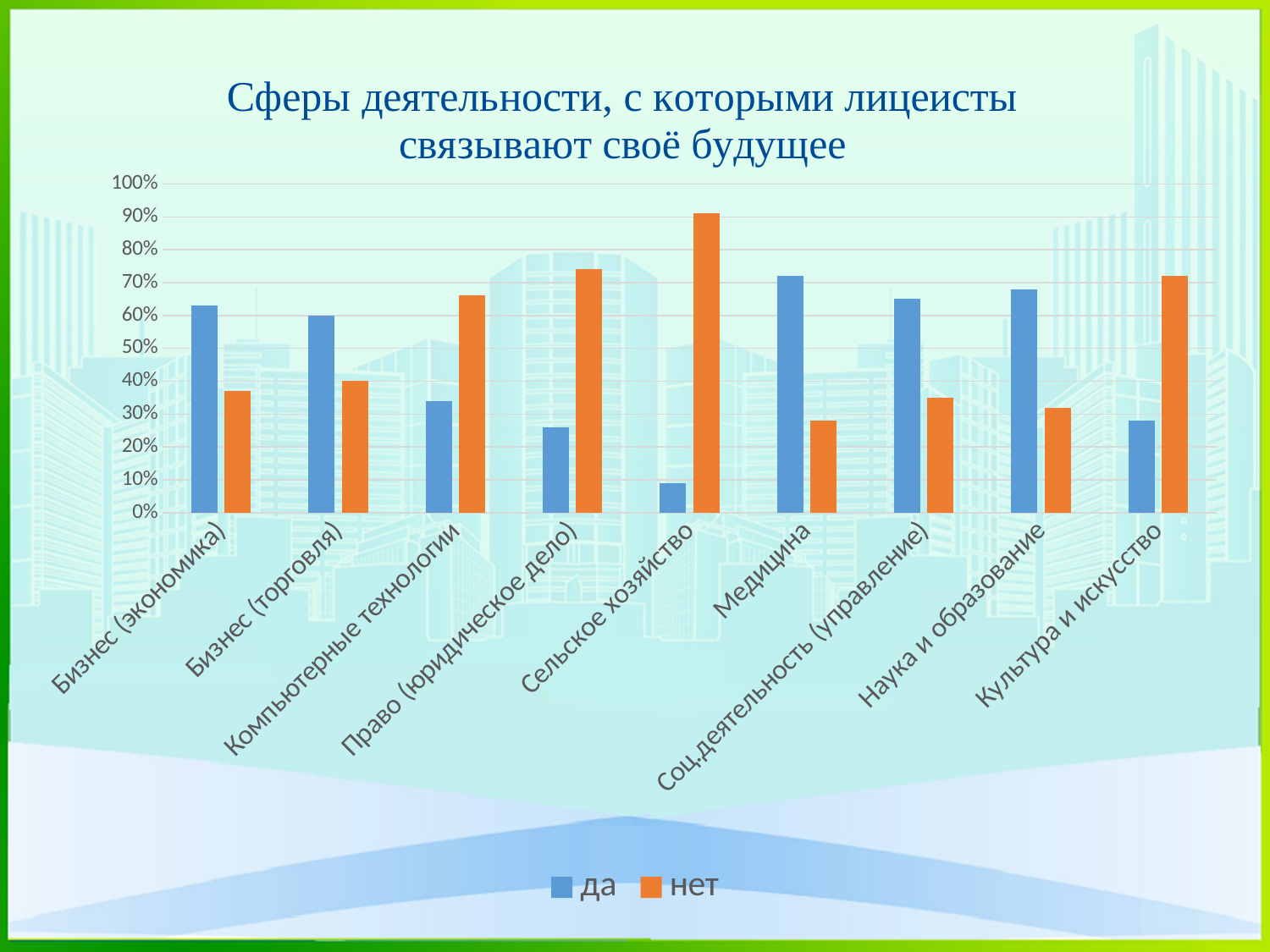
What are the two series named in the legend? да and нет Is the 'да' value for Медицина greater or less than 60%? greater Is the 'нет' value for Сельское хозяйство greater or less than 80%? greater For Культура и искусство, which series has the larger value, 'да' or 'нет'? нет Is the 'нет' value for Право (юридическое дело) greater or less than 60%? greater How many series does the legend list? 2 What kind of chart is shown on the slide? bar chart Which category has the lowest value for the 'да' series? Сельское хозяйство Which category has the highest value for the 'нет' series? Сельское хозяйство For Наука и образование, which series has the larger value, 'да' or 'нет'? да How many categories (spheres of activity) are shown on the x axis? 9